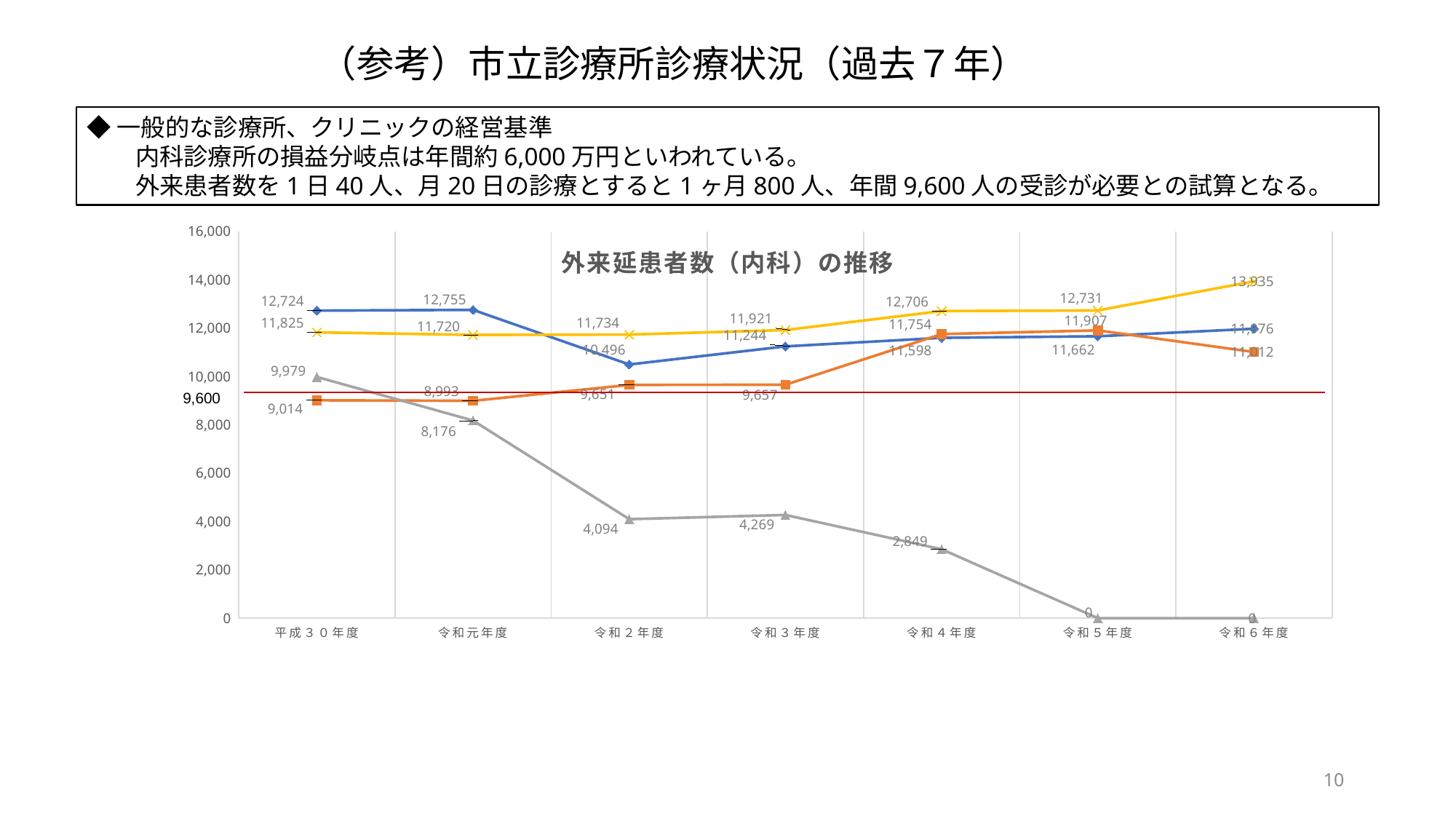
What is the value of the orange line (square markers) for 令和４年度? 11,754 What is the value of the yellow line (x markers) for 令和５年度? 12,731 How many fiscal years are shown on the x axis of the chart? 7 Which is larger for 令和３年度: the yellow line value or the blue line value? the yellow line value (11,921) What is the difference between the gray line values for 令和元年度 (8,176) and 令和２年度 (4,094)? 4,082 Which fiscal year has the lowest value on the blue line (diamond markers)? 令和２年度 What is the value of the blue line (diamond markers) for 令和元年度? 12,755 What is the value of the gray line (triangle markers) for 平成３０年度? 9,979 Does the gray line (triangle markers) rise or fall from 平成３０年度 to 令和６年度? fall What kind of chart is shown on the slide? line chart What is the value of the gray line (triangle markers) for 令和５年度? 0 What is the title of the chart? 外来延患者数（内科）の推移